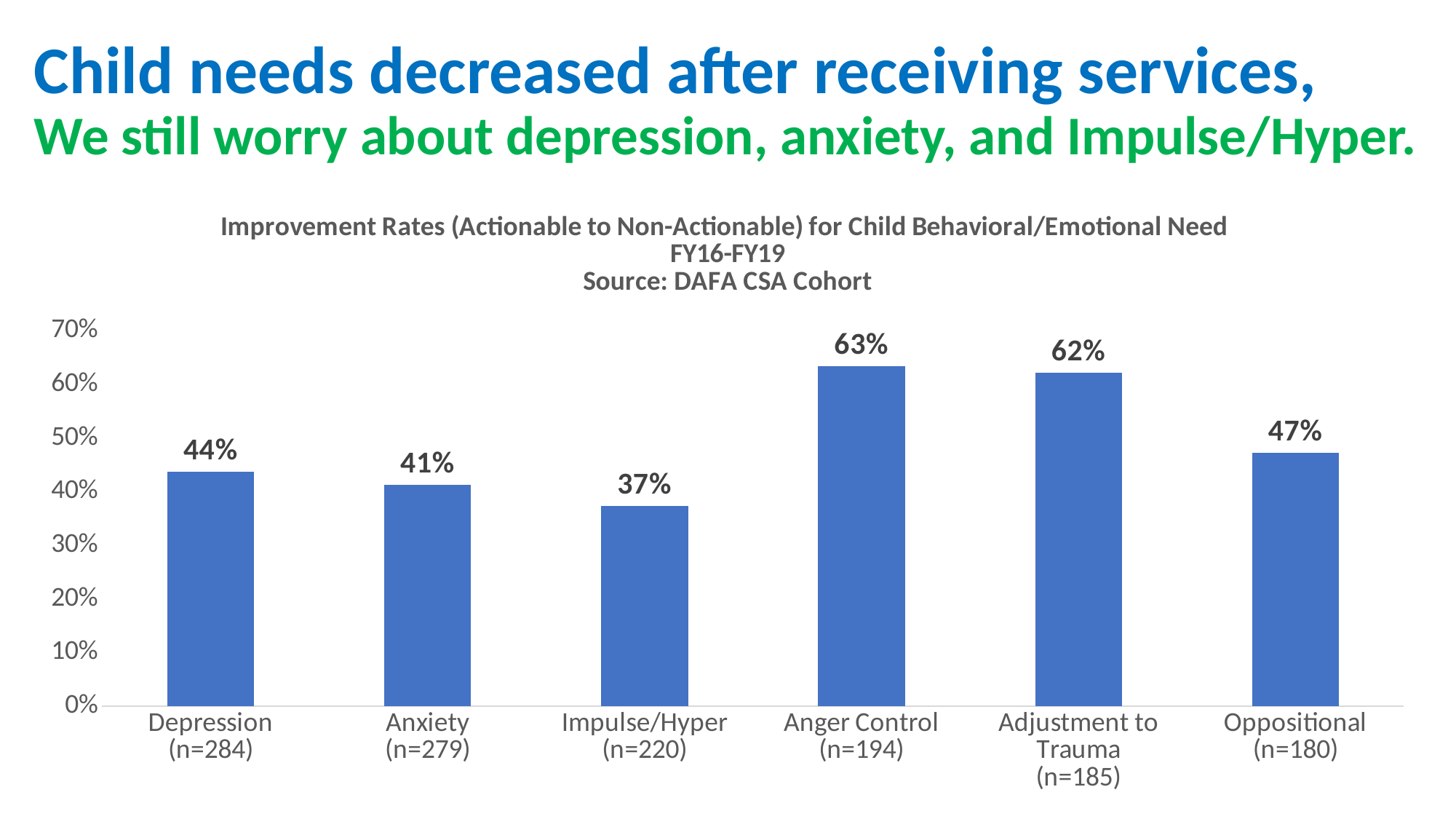
What is the improvement rate for Depression? 44% Which need has the lowest improvement rate? Impulse/Hyper How many needs are shown on the x axis? 6 Which has a higher improvement rate, Depression or Oppositional? Oppositional What is the improvement rate for Anger Control? 63% What is the difference between the improvement rates for Anger Control and Impulse/Hyper? 26% What is the sample size (n) for Anxiety? 279 What is the improvement rate for Oppositional? 47% What fiscal years does the chart cover? FY16-FY19 What kind of chart is shown on the slide? Bar chart Which need has the highest improvement rate? Anger Control What is the source named in the chart title? DAFA CSA Cohort